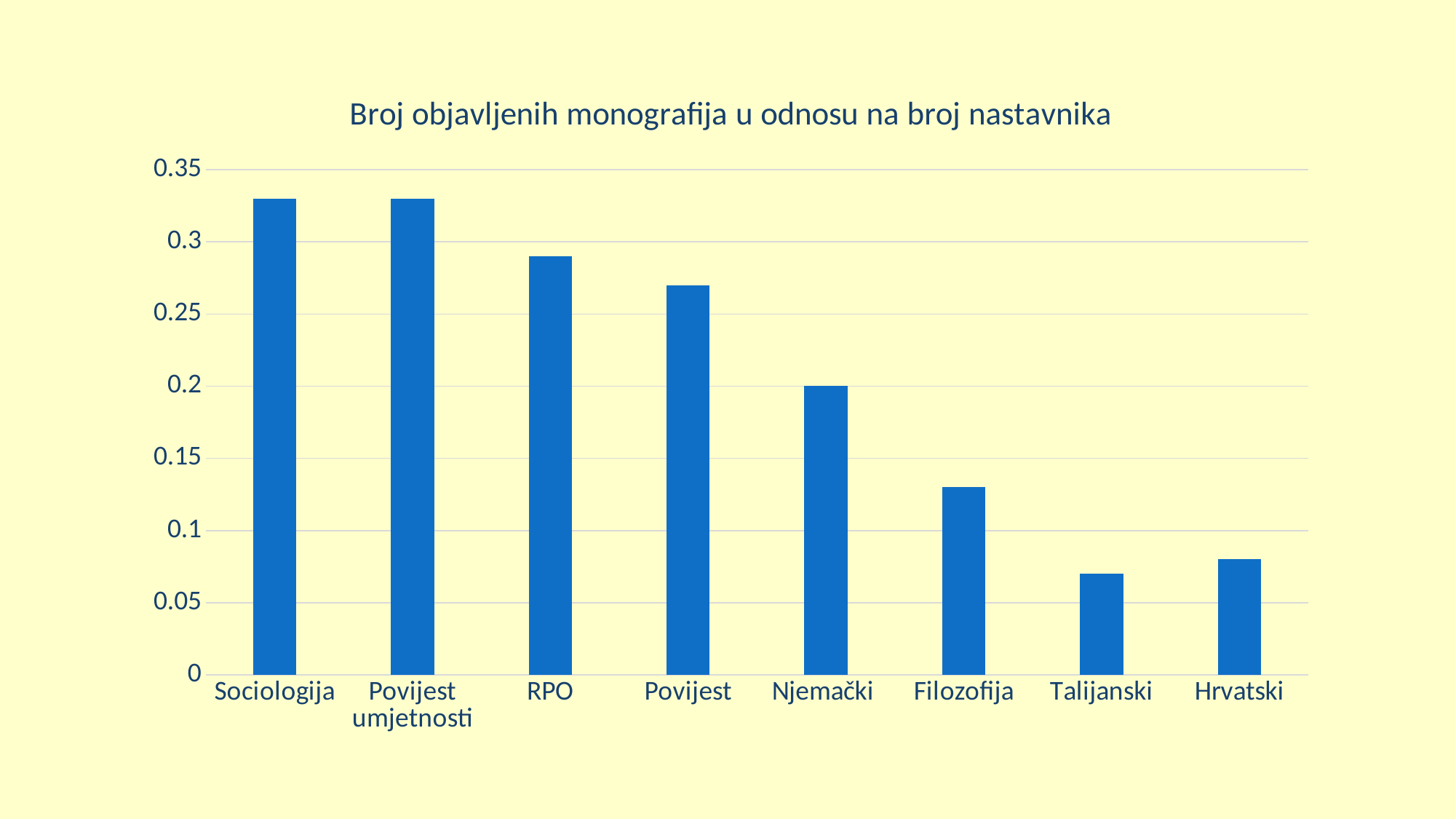
What kind of chart is shown on the slide? bar chart Is the value for RPO greater or less than 0.3? less Is the value for Hrvatski greater or less than 0.1? less Is the value for Filozofija greater or less than 0.15? less Which has a larger value, RPO or Povijest? RPO What is the title of the chart? Broj objavljenih monografija u odnosu na broj nastavnika How many categories are shown on the x axis of the chart? 8 Which category has the lowest value in the chart? Talijanski What is the value for Njemački? 0.2 Which has a larger value, Hrvatski or Talijanski? Hrvatski